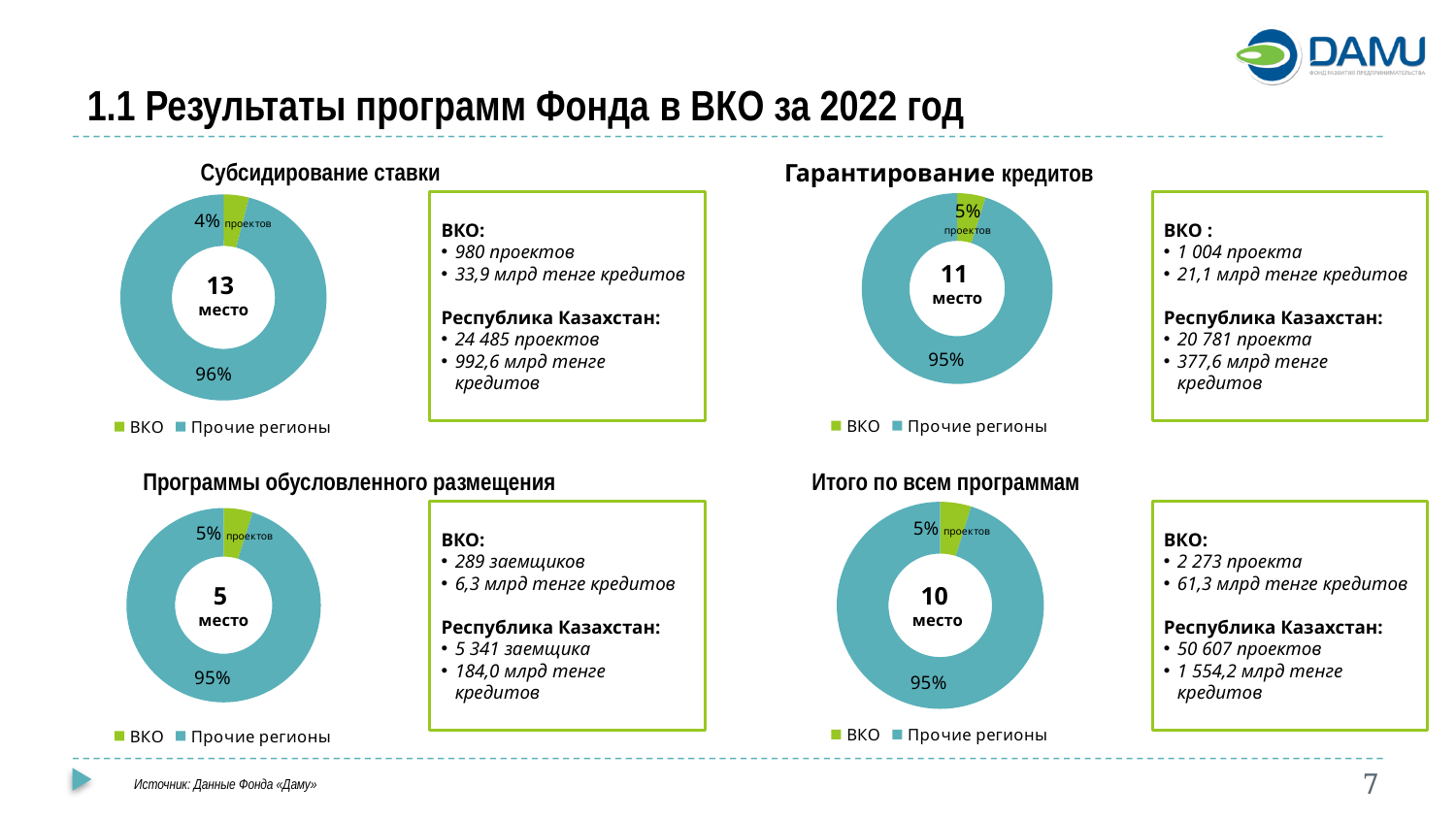
In the 'Субсидирование ставки' chart, which slice is larger: ВКО or Прочие регионы? Прочие регионы In the 'Гарантирование кредитов' chart, what share of projects does ВКО account for? 5% What rank (место) is shown in the centre of the 'Программы обусловленного размещения' chart? 5 место In the 'Итого по всем программам' chart, which category has the smallest share? ВКО What type of chart is used for 'Гарантирование кредитов'? Pie (donut) chart In the 'Гарантирование кредитов' chart, what share is shown for Прочие регионы? 95% In the 'Итого по всем программам' chart, what share of projects does ВКО account for? 5% In the 'Субсидирование ставки' chart, what is the difference between the shares of Прочие регионы and ВКО? 92% In the 'Субсидирование ставки' chart, what share of projects does ВКО account for? 4% In the 'Программы обусловленного размещения' chart, what share is shown for Прочие регионы? 95% In the 'Субсидирование ставки' chart, what share is shown for Прочие регионы? 96% How many categories does the legend of the 'Программы обусловленного размещения' chart list? 2